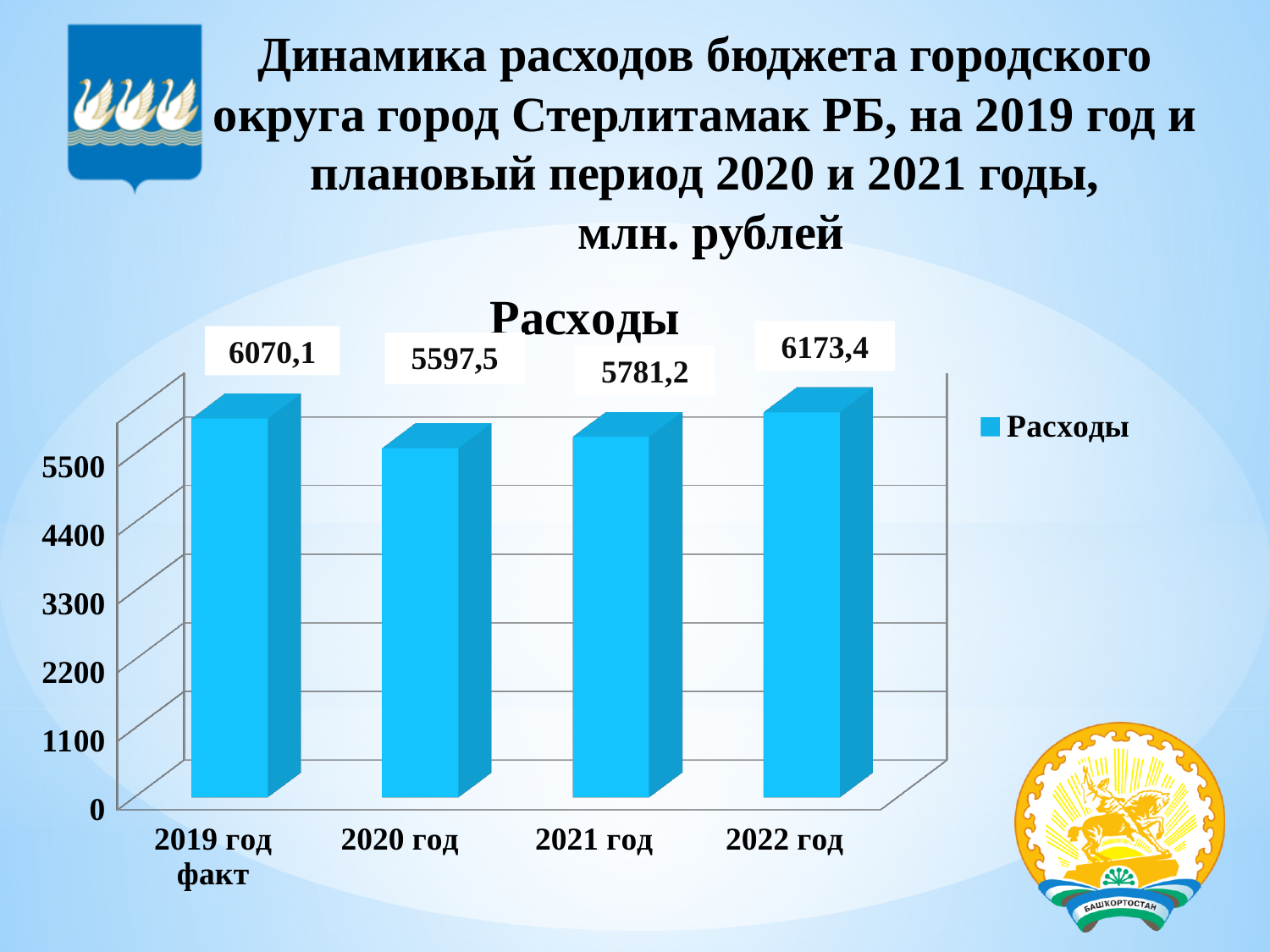
From 2020 год to 2022 год, do the values rise or fall? Rise What is the value for 2020 год? 5597,5 Which year has the lowest value? 2020 год What is the value for 2022 год? 6173,4 What is the difference between the values for 2021 год and 2020 год? 183,7 How many categories are shown on the x axis? 4 Which year has the highest value? 2022 год What kind of chart is this? Bar chart What is the value for 2021 год? 5781,2 What is the difference between the values for 2022 год and 2019 год факт? 103,3 Which is larger, the value for 2019 год факт or the value for 2021 год? 2019 год факт What is the value for 2019 год факт? 6070,1